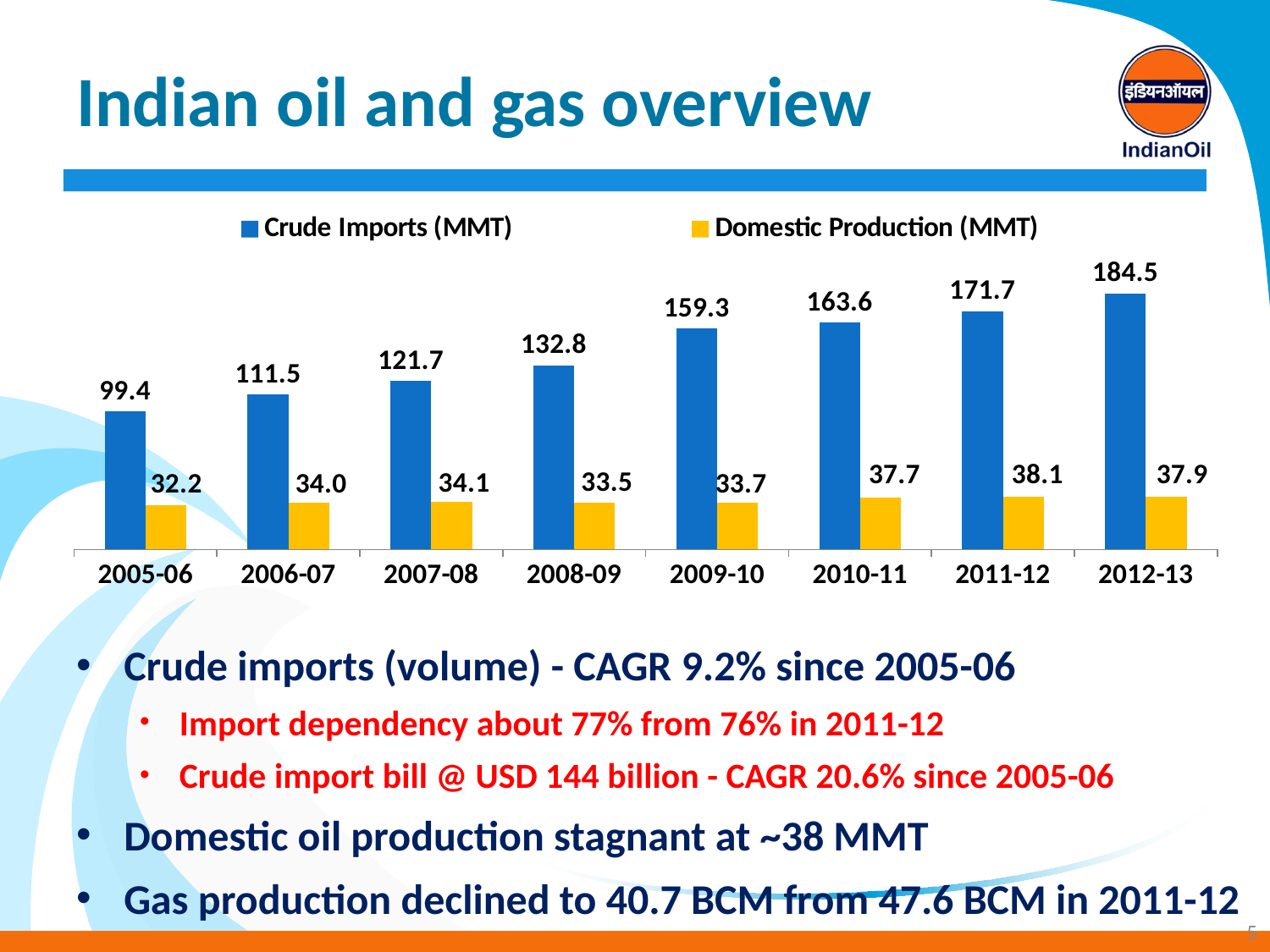
What is the value of Domestic Production (MMT) for 2005-06? 32.2 Which is larger: Domestic Production (MMT) in 2011-12 or in 2012-13? 2011-12 Do Crude Imports (MMT) rise or fall from 2005-06 to 2012-13? Rise Which year has the lowest Domestic Production (MMT)? 2005-06 How many series does the legend list? 2 What is the value of Crude Imports (MMT) for 2012-13? 184.5 What is the difference between Crude Imports (MMT) in 2012-13 and 2005-06? 85.1 Which colour represents Domestic Production (MMT) in the chart? Yellow What kind of chart is shown on the slide? Bar chart Which year has the highest Crude Imports (MMT)? 2012-13 What is the value of Crude Imports (MMT) for 2009-10? 159.3 How many years are shown on the x axis? 8